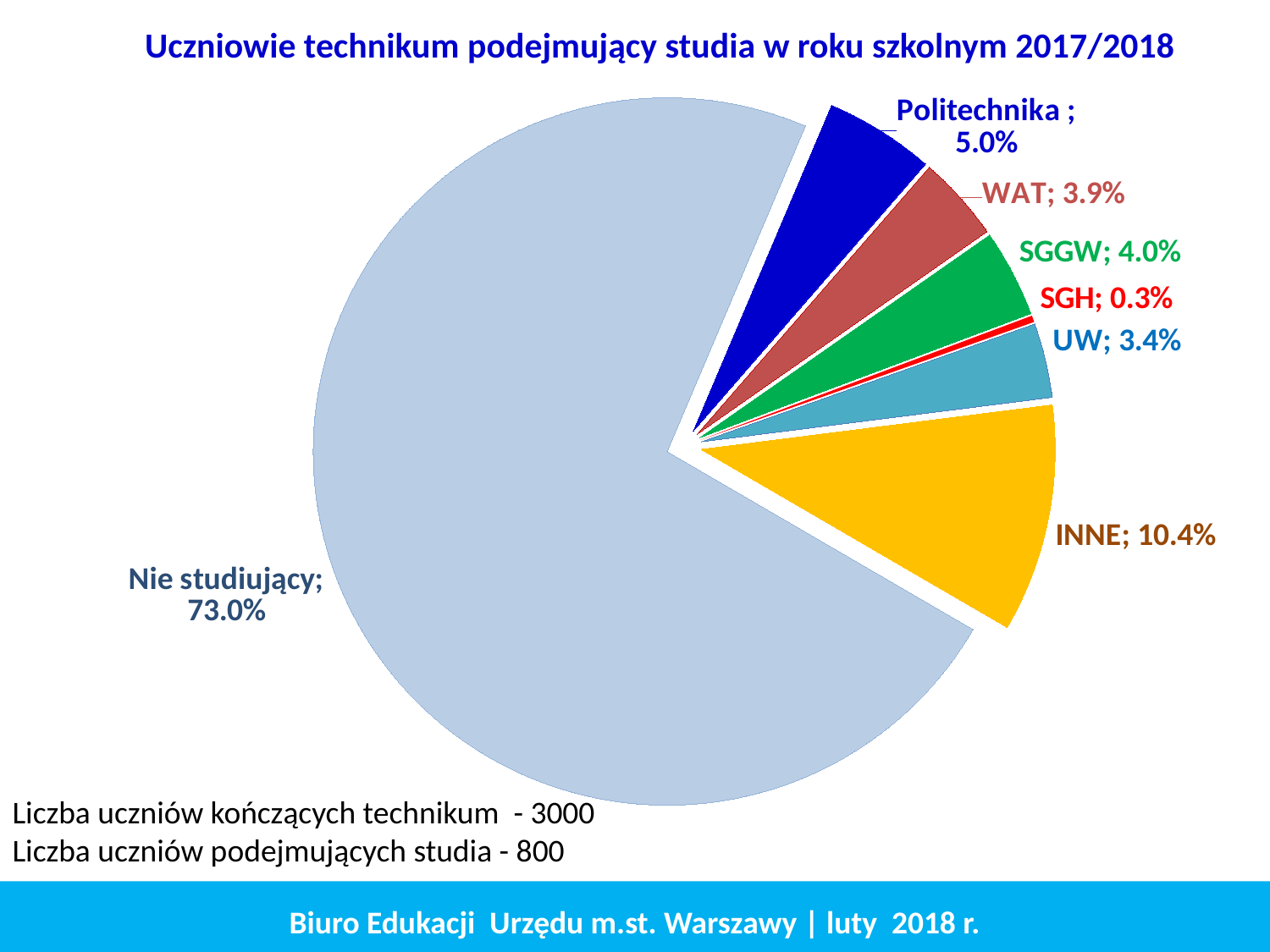
What is the value shown for SGH? 0.3% What share of the pie does 'Nie studiujący' represent? 73.0% Which category has the smallest slice of the pie? SGH How many slices does the pie chart have? 7 What kind of chart is shown on the slide? Pie chart Which is larger, the value for SGGW or the value for WAT? SGGW What is the value shown for INNE? 10.4% What is the value shown for UW? 3.4% What is the title of the chart? Uczniowie technikum podejmujący studia w roku szkolnym 2017/2018 What is the value shown for Politechnika? 5.0% What is the difference between the values for INNE and Politechnika? 5.4% Which category has the largest slice of the pie? Nie studiujący